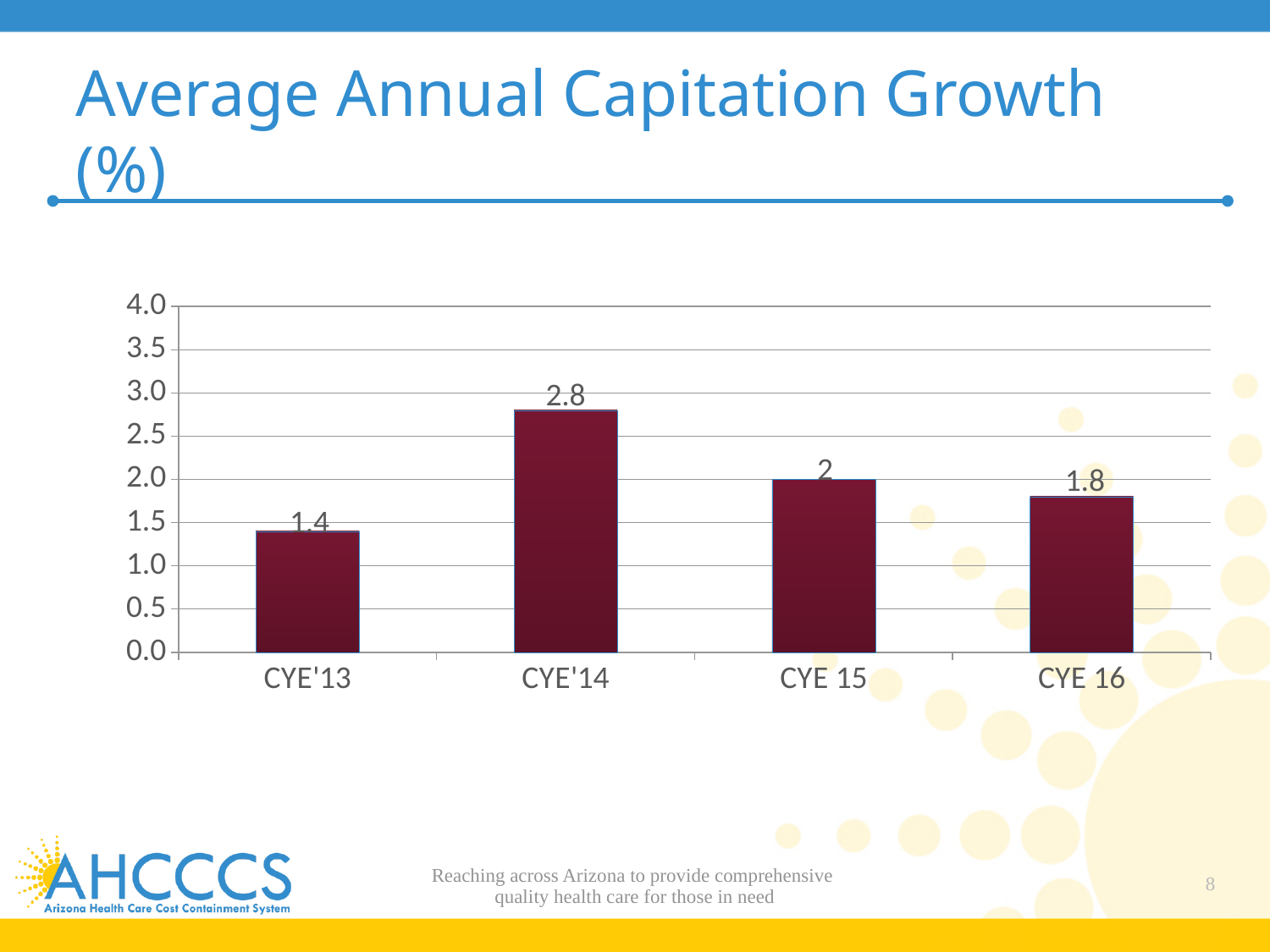
What is the value for CYE 15? 2 Which category has the lowest value? CYE'13 What kind of chart is shown on the slide? bar chart How many categories are shown on the x axis? 4 What is the value for CYE 16? 1.8 Is the value for CYE'14 greater or less than 2.5? greater What is the title of the chart on the slide? Average Annual Capitation Growth (%) What is the value for CYE'13? 1.4 Which category has the highest value? CYE'14 Which is larger, the value for CYE 15 or the value for CYE 16? CYE 15 What is the value for CYE'14? 2.8 What is the difference between the values for CYE'14 and CYE'13? 1.4